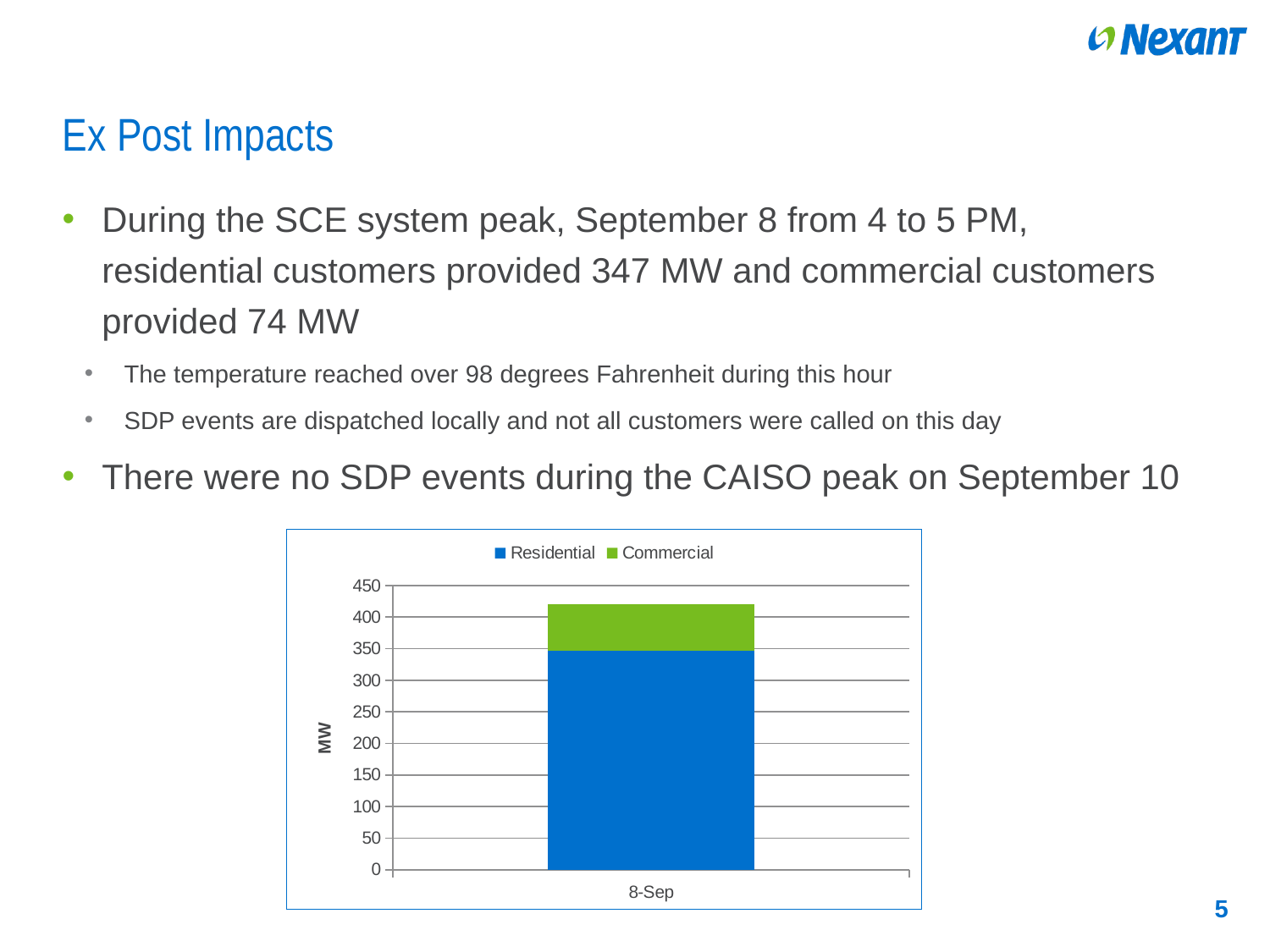
What is the maximum value shown on the y axis of the chart? 450 Which series are listed in the chart legend? Residential and Commercial Is the total height of the 8-Sep stacked bar greater or less than 450? less Which series contributes more to the 8-Sep bar, Residential or Commercial? Residential Is the Residential value for 8-Sep greater or less than 250? greater What is the y axis label of the chart? MW How many series does the chart legend list? 2 How many categories are shown on the x axis of the chart? 1 Is the Residential value for 8-Sep greater or less than 300? greater What kind of chart is shown on the slide? stacked bar chart